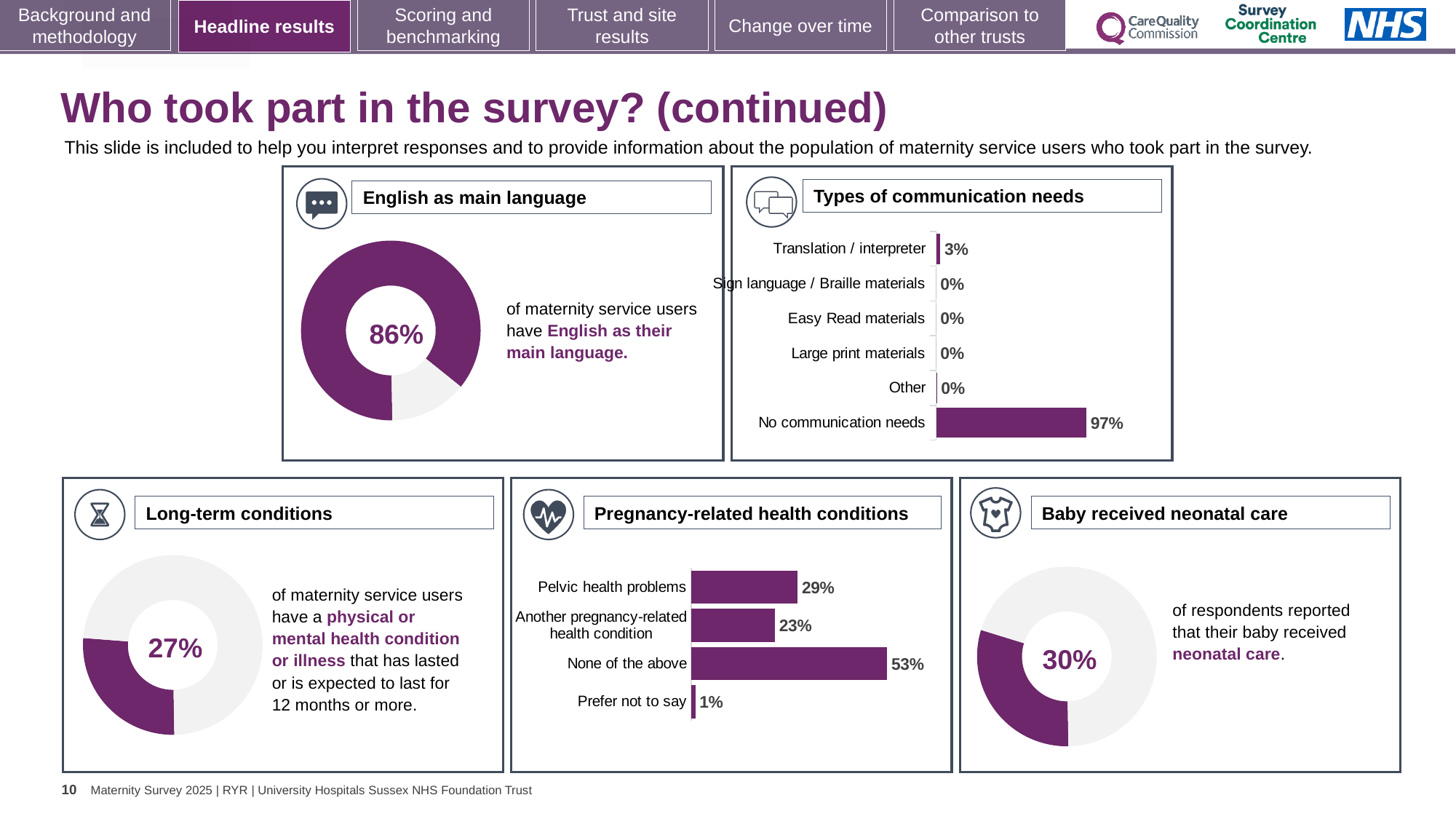
In the 'Long-term conditions' chart, what percentage of maternity service users have a physical or mental health condition or illness? 27% In the 'Baby received neonatal care' chart, what percentage of respondents reported that their baby received neonatal care? 30% In the 'Pregnancy-related health conditions' chart, which is larger: 'Pelvic health problems' or 'Another pregnancy-related health condition'? Pelvic health problems What kind of chart is used in the 'Pregnancy-related health conditions' panel? Bar chart In the 'Pregnancy-related health conditions' chart, what is the value for 'Pelvic health problems'? 29% In the 'Pregnancy-related health conditions' chart, which category has the lowest value? Prefer not to say In the 'English as main language' chart, what percentage of maternity service users have English as their main language? 86% In the 'Types of communication needs' chart, which category has the highest value? No communication needs In the 'Types of communication needs' chart, how many categories are shown? 6 In the 'Pregnancy-related health conditions' chart, what is the difference between 'None of the above' and 'Pelvic health problems'? 24% In the 'Types of communication needs' chart, what is the difference between 'No communication needs' and 'Translation / interpreter'? 94% In the 'Types of communication needs' chart, what is the value for 'Translation / interpreter'? 3%